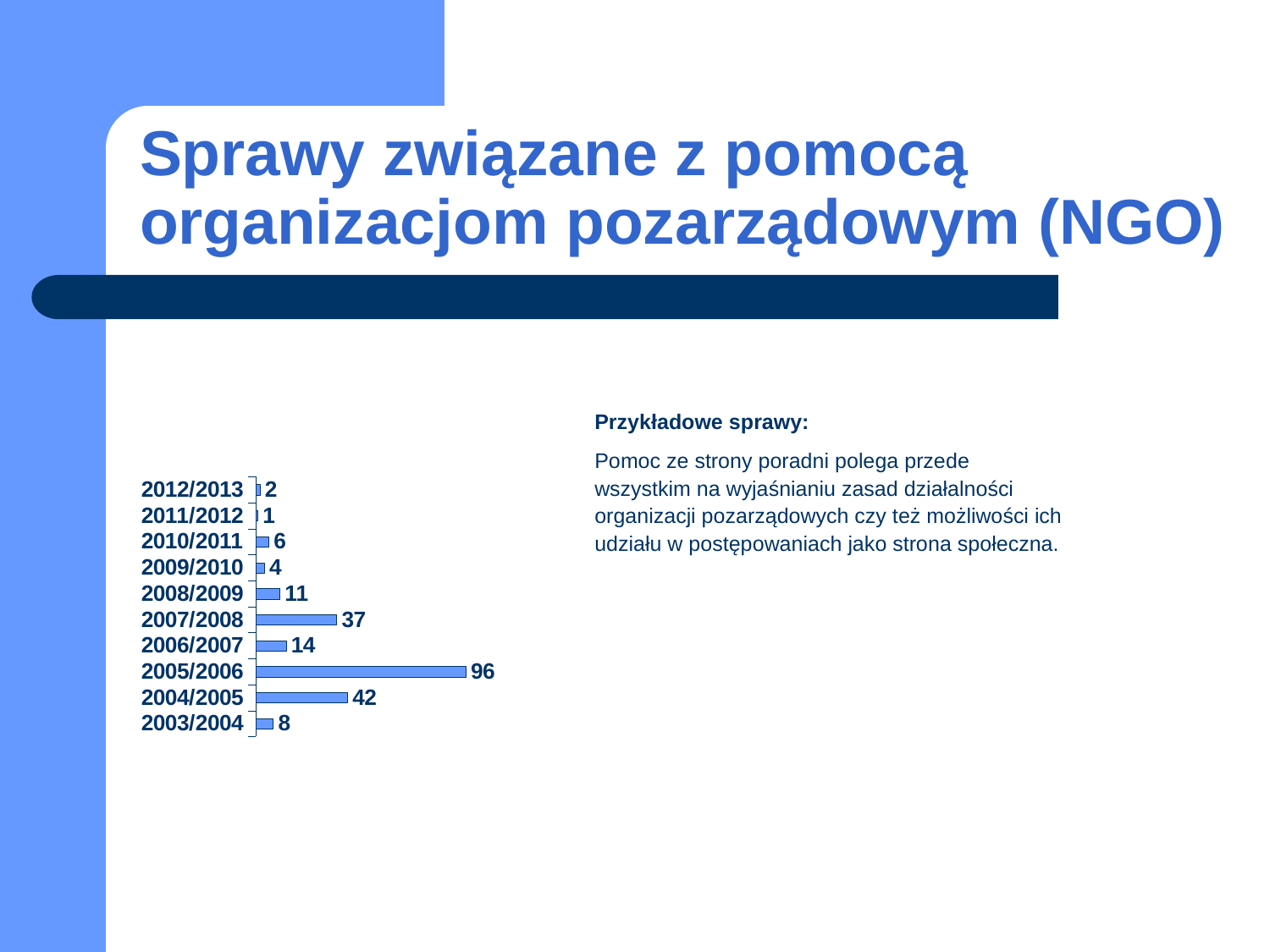
What kind of chart is shown on the slide? bar chart What is the difference between the values for 2005/2006 and 2004/2005? 54 How many categories does the chart show? 10 Which category has the highest value? 2005/2006 Which is larger, the value for 2008/2009 or the value for 2006/2007? 2006/2007 Which category has the lowest value? 2011/2012 What is the value for 2010/2011? 6 What is the value for 2003/2004? 8 What is the value for 2012/2013? 2 What is the difference between the values for 2007/2008 and 2006/2007? 23 What is the value for 2007/2008? 37 What is the value for 2005/2006? 96